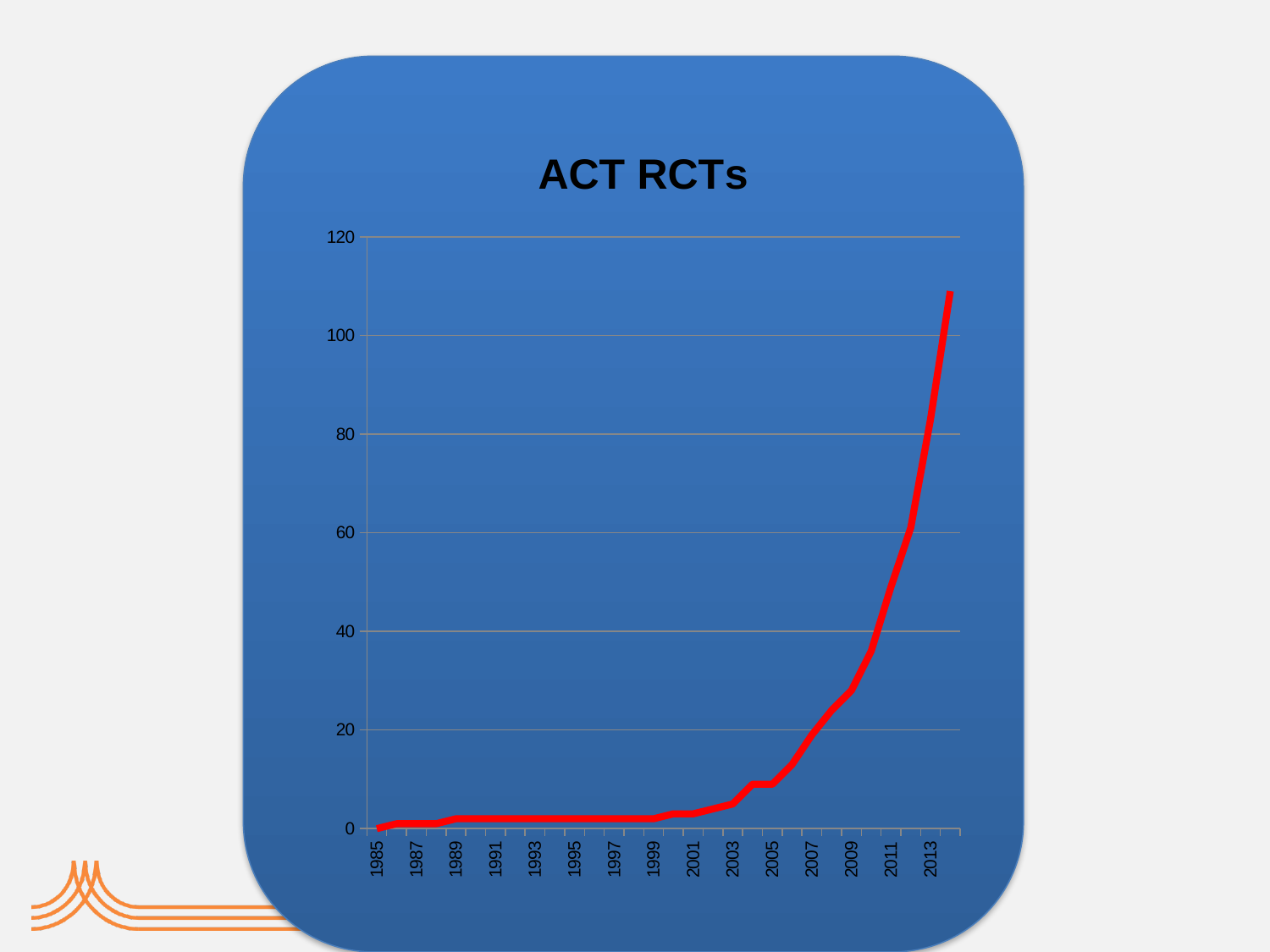
Is the value for 1995 greater or less than 20? less What kind of chart is shown on the slide? line chart What is the title of the chart? ACT RCTs Is the value for 2009 greater or less than 40? less Is the value at the final point of the line greater or less than 100? greater Do the values generally rise or fall from 1985 to 2013? rise Which of the labeled years on the x axis has the highest value? 2013 Which of the labeled years on the x axis has the lowest value? 1985 Which year has the larger value, 2005 or 2009? 2009